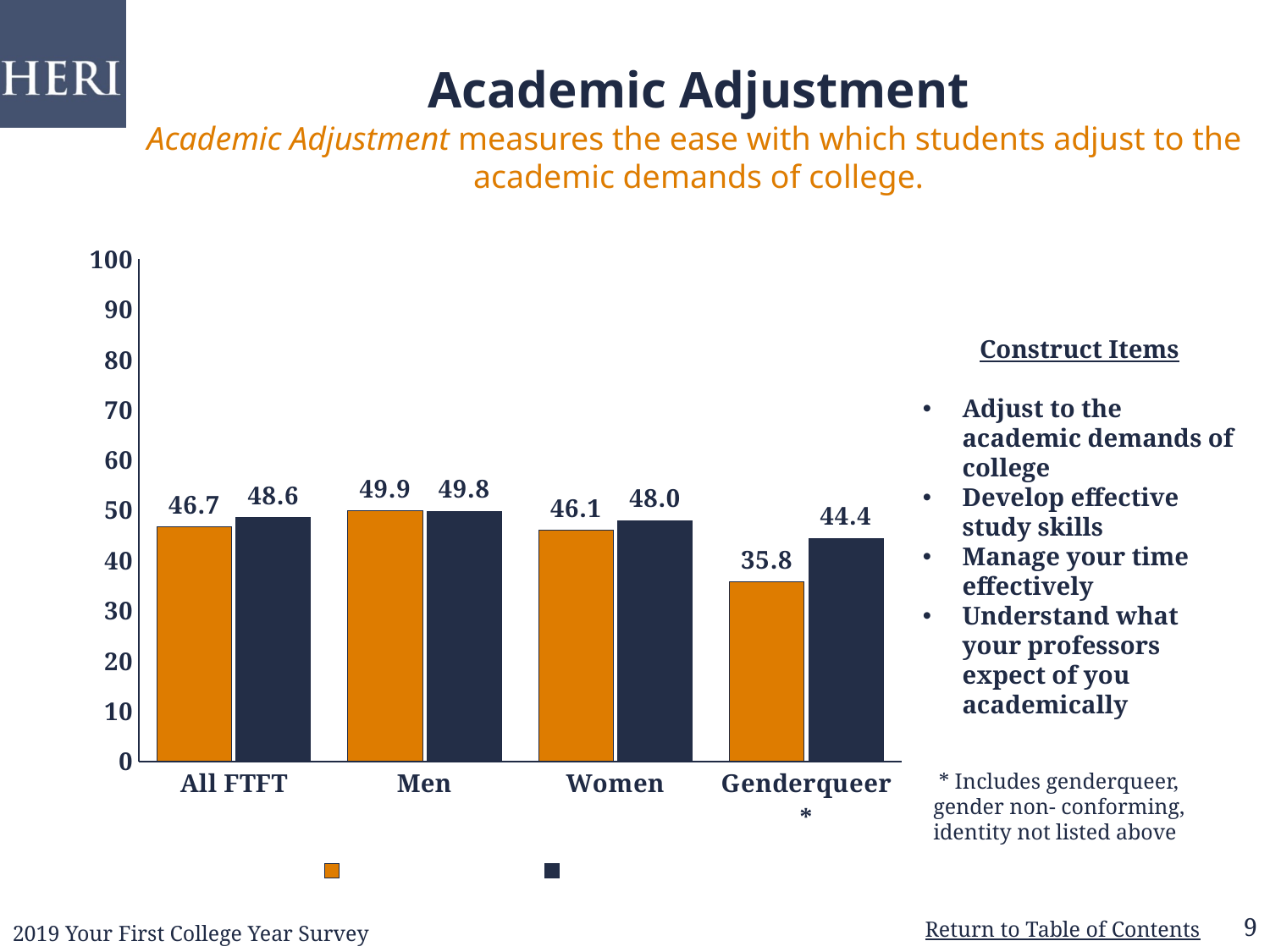
What is the difference between the dark navy bar and the orange bar for All FTFT? 1.9 What kind of chart is shown on the slide? bar chart What is the value of the dark navy bar for Men? 49.8 For Women, which bar is larger, the orange bar or the dark navy bar? dark navy bar What is the difference between the dark navy bar and the orange bar for Genderqueer*? 8.6 What is the value of the dark navy bar for Genderqueer*? 44.4 What is the value of the orange bar for All FTFT? 46.7 How many series does the legend list? 2 What is the value of the orange bar for Women? 46.1 How many categories are shown on the x axis? 4 Which category has the highest orange bar? Men Which category has the lowest orange bar? Genderqueer*